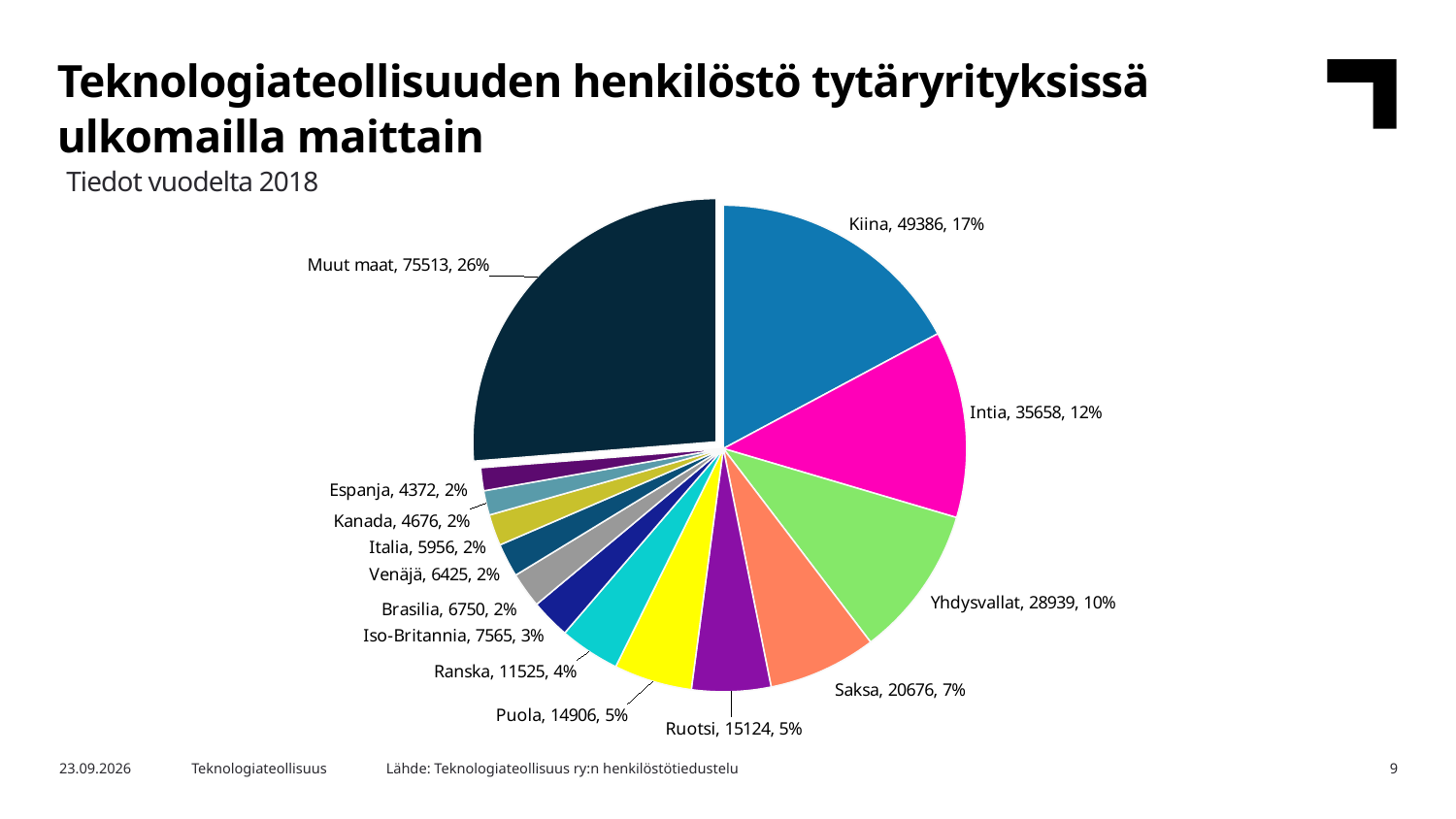
What is the value for Saksa? 20676 What is the value for Kiina? 49386 What kind of chart is shown on the slide? Pie chart What share of the pie does Intia represent? 12% What share of the pie does Yhdysvallat represent? 10% What is the difference between the values for Kiina and Intia? 13728 Which is larger, the value for Ruotsi or the value for Puola? Ruotsi Which slice is the smallest? Espanja What year does the data on the slide come from? 2018 What is the value for Iso-Britannia? 7565 Which slice is the largest? Muut maat How many slices does the pie chart have? 14